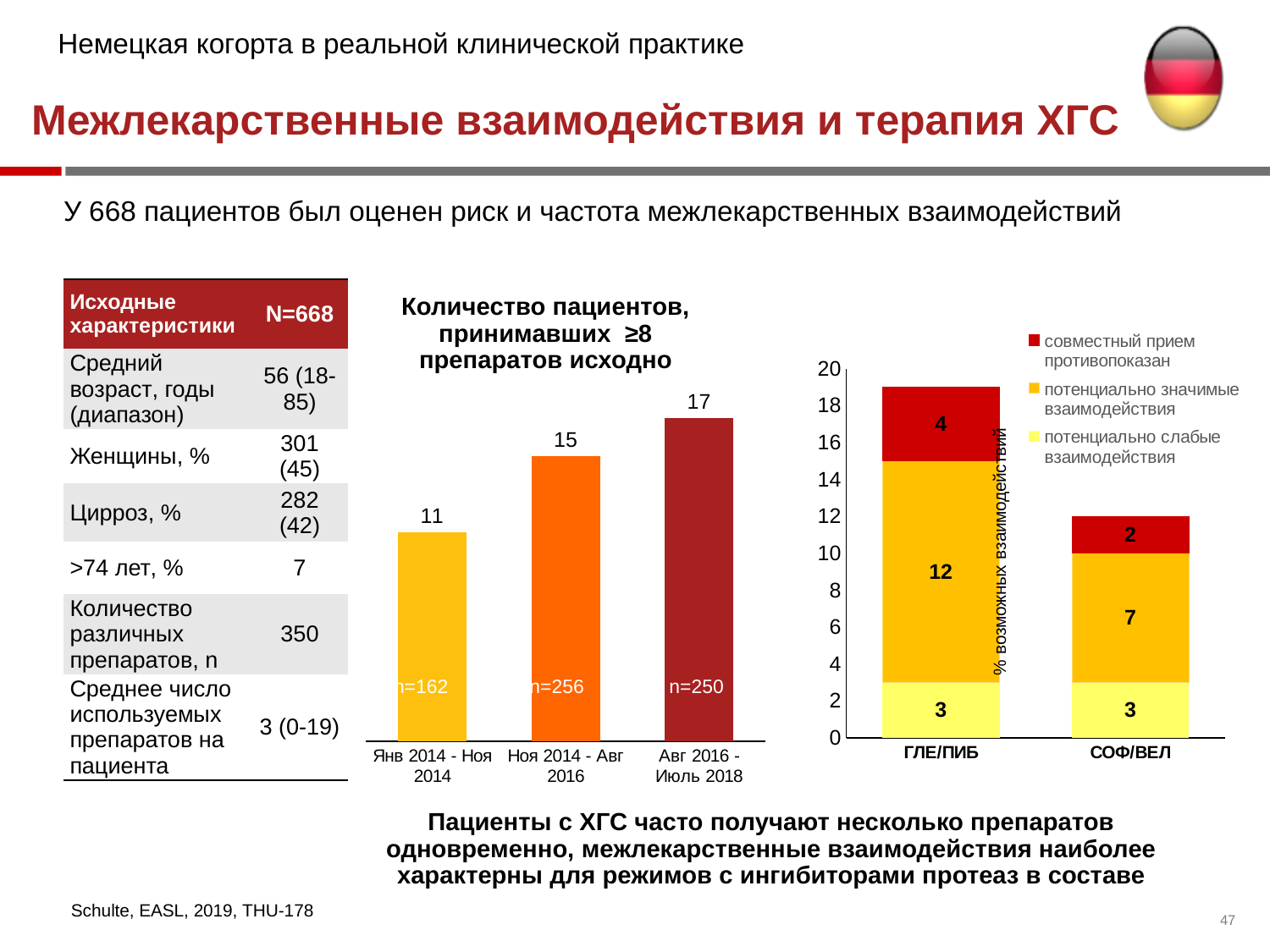
What kind of chart is the one on the right of the slide, with categories ГЛЕ/ПИБ and СОФ/ВЕЛ? stacked bar chart In the stacked bar chart on the right, which regimen has the larger "потенциально значимые взаимодействия" segment, ГЛЕ/ПИБ or СОФ/ВЕЛ? ГЛЕ/ПИБ In the stacked bar chart on the right, what is the total of the stacked bar for СОФ/ВЕЛ? 12 In the chart titled "Количество пациентов, принимавших ≥8 препаратов исходно", how many bars are plotted? 3 In the chart titled "Количество пациентов, принимавших ≥8 препаратов исходно", do the values rise or fall from left to right along the x axis? rise In the chart titled "Количество пациентов, принимавших ≥8 препаратов исходно", what is the value for the period Авг 2016 - Июль 2018? 17 In the chart titled "Количество пациентов, принимавших ≥8 препаратов исходно", what is the difference between the values for Ноя 2014 - Авг 2016 and Янв 2014 - Ноя 2014? 4 In the stacked bar chart on the right, what is the value of the "совместный прием противопоказан" segment for ГЛЕ/ПИБ? 4 In the chart titled "Количество пациентов, принимавших ≥8 препаратов исходно", which period has the lowest value? Янв 2014 - Ноя 2014 In the stacked bar chart on the right, how many series does the legend list? 3 In the stacked bar chart on the right, what is the total of the stacked bar for ГЛЕ/ПИБ? 19 In the stacked bar chart on the right, what is the value of the "потенциально значимые взаимодействия" segment for СОФ/ВЕЛ? 7